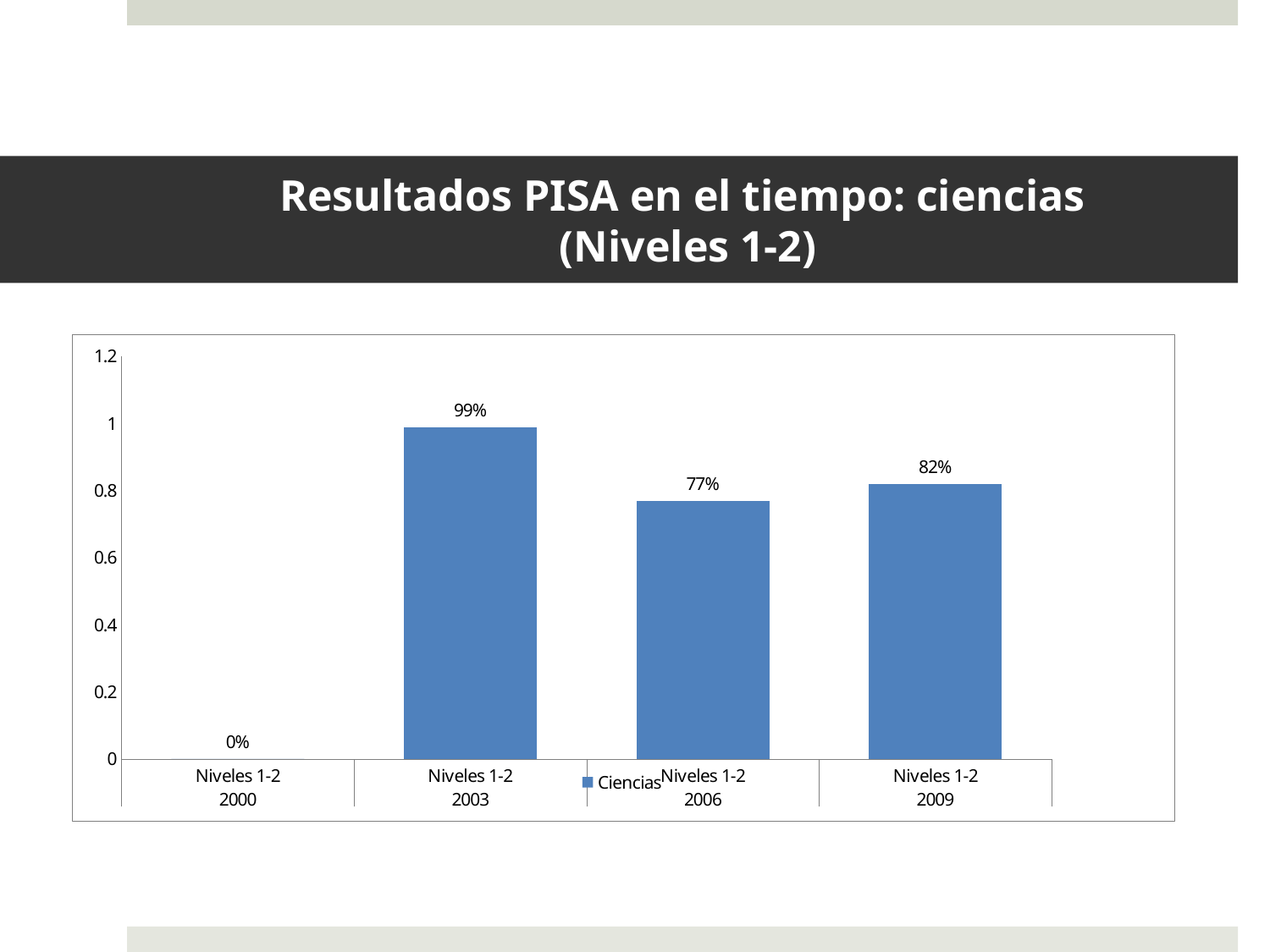
How many categories are shown on the x axis? 4 How many series does the legend list? 1 What is the name of the series shown in the legend? Ciencias What is the value for Niveles 1-2 2003? 99% Which category has the lowest value? Niveles 1-2 2000 Which is larger, the value for Niveles 1-2 2006 or Niveles 1-2 2009? Niveles 1-2 2009 What is the difference between the values for Niveles 1-2 2003 and Niveles 1-2 2006? 22% What is the value for Niveles 1-2 2009? 82% What kind of chart is shown on the slide? Bar chart What is the value for Niveles 1-2 2006? 77% Which category has the highest value? Niveles 1-2 2003 What is the value for Niveles 1-2 2000? 0%